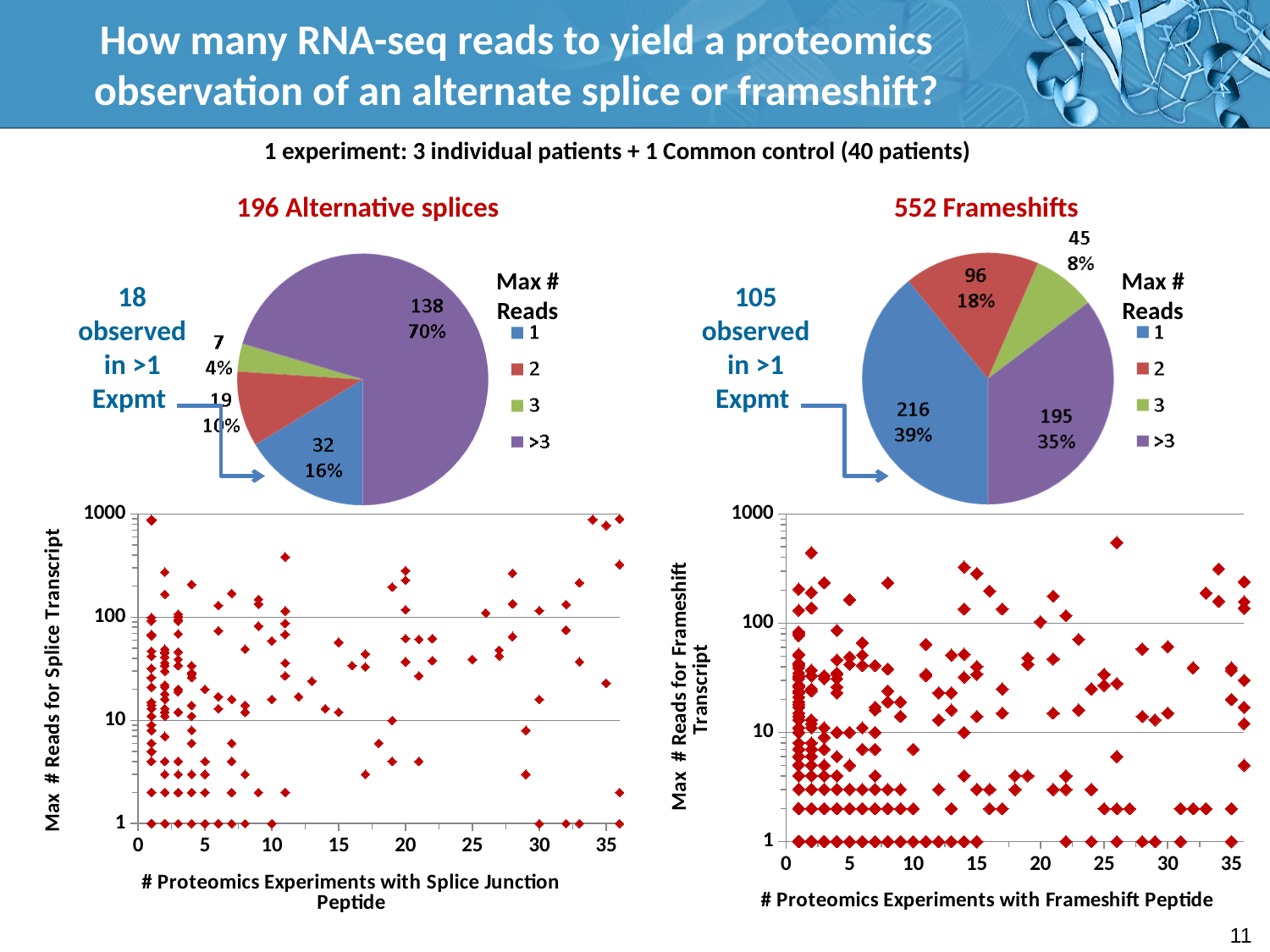
How many categories does the legend of the '196 Alternative splices' pie chart list? 4 In the '552 Frameshifts' pie chart, what share of the pie is the '3' read slice? 8% What kind of chart is the bottom-left chart titled 'Max # Reads for Splice Transcript' versus '# Proteomics Experiments with Splice Junction Peptide'? Scatter plot In the '196 Alternative splices' pie chart, which max-reads category has the smallest slice? 3 In the '196 Alternative splices' pie chart, what is the difference between the '>3' slice and the '1' slice? 106 In the '196 Alternative splices' pie chart, what share of the pie is the '1' read slice? 16% What is the x-axis title of the bottom-right scatter plot? # Proteomics Experiments with Frameshift Peptide In the '552 Frameshifts' pie chart, how many frameshifts have a max of 2 reads? 96 In the '552 Frameshifts' pie chart, which max-reads category has the largest slice? 1 In the '196 Alternative splices' pie chart, how many alternative splices have a max of >3 reads? 138 In the '552 Frameshifts' pie chart, what is the difference between the '1' slice and the '>3' slice? 21 In the '552 Frameshifts' pie chart, which is larger, the '1' slice or the '>3' slice? 1